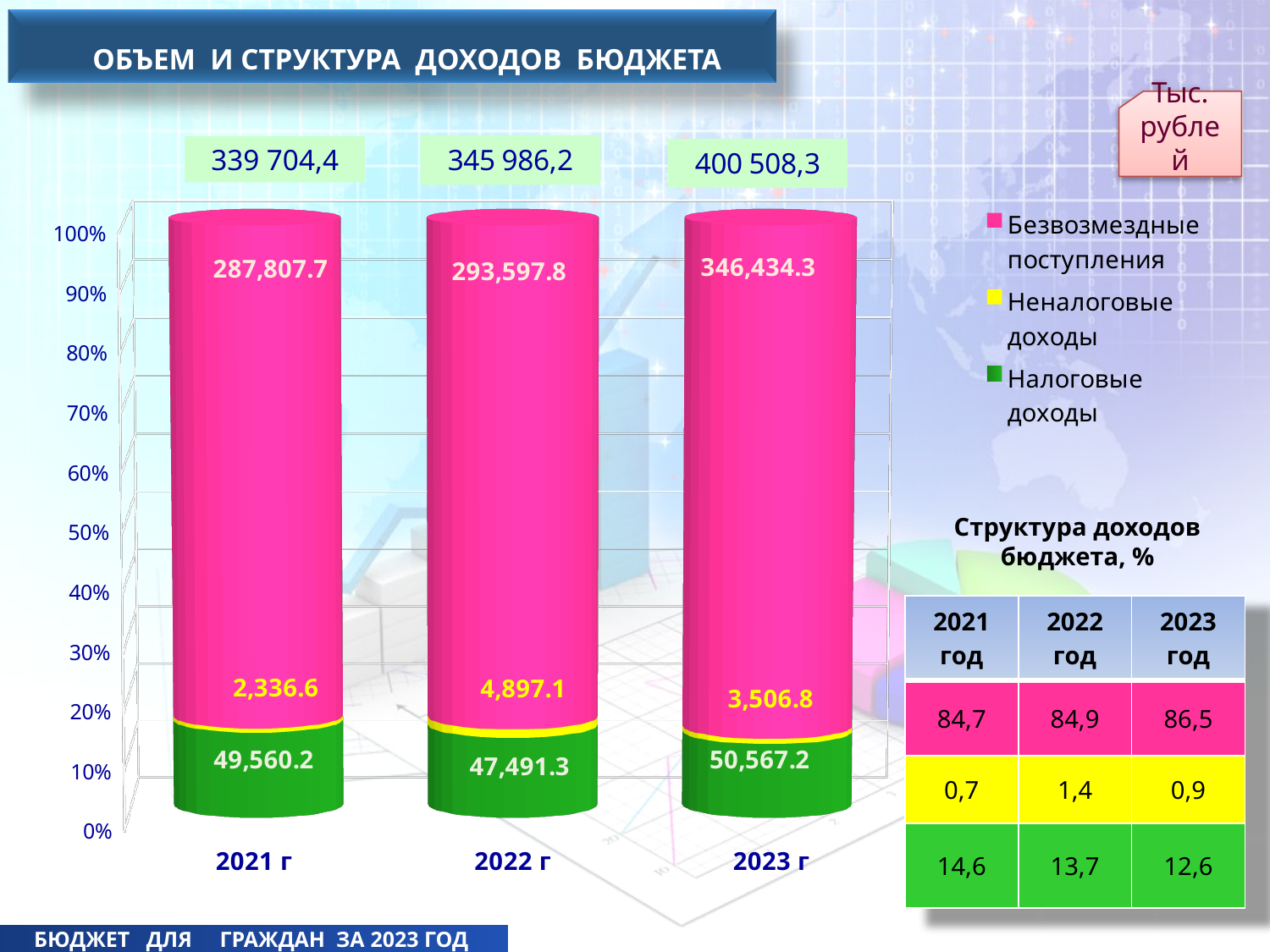
What is the value of Неналоговые доходы for 2022 г? 4,897.1 What kind of chart is shown on the slide? Bar chart How many years are shown on the x axis of the chart? 3 What total is printed above the bar for 2023 г? 400 508,3 Which is larger: Налоговые доходы in 2021 г or in 2022 г? 2021 г What is the difference between Налоговые доходы in 2023 г and in 2022 г? 3,075.9 What is the difference between Безвозмездные поступления in 2023 г and in 2021 г? 58,626.6 In which year is the value of Безвозмездные поступления the highest? 2023 г What is the value of Налоговые доходы for 2023 г? 50,567.2 In which year is the value of Неналоговые доходы the lowest? 2021 г How many series does the chart legend list? 3 What is the value of Безвозмездные поступления for 2021 г? 287,807.7